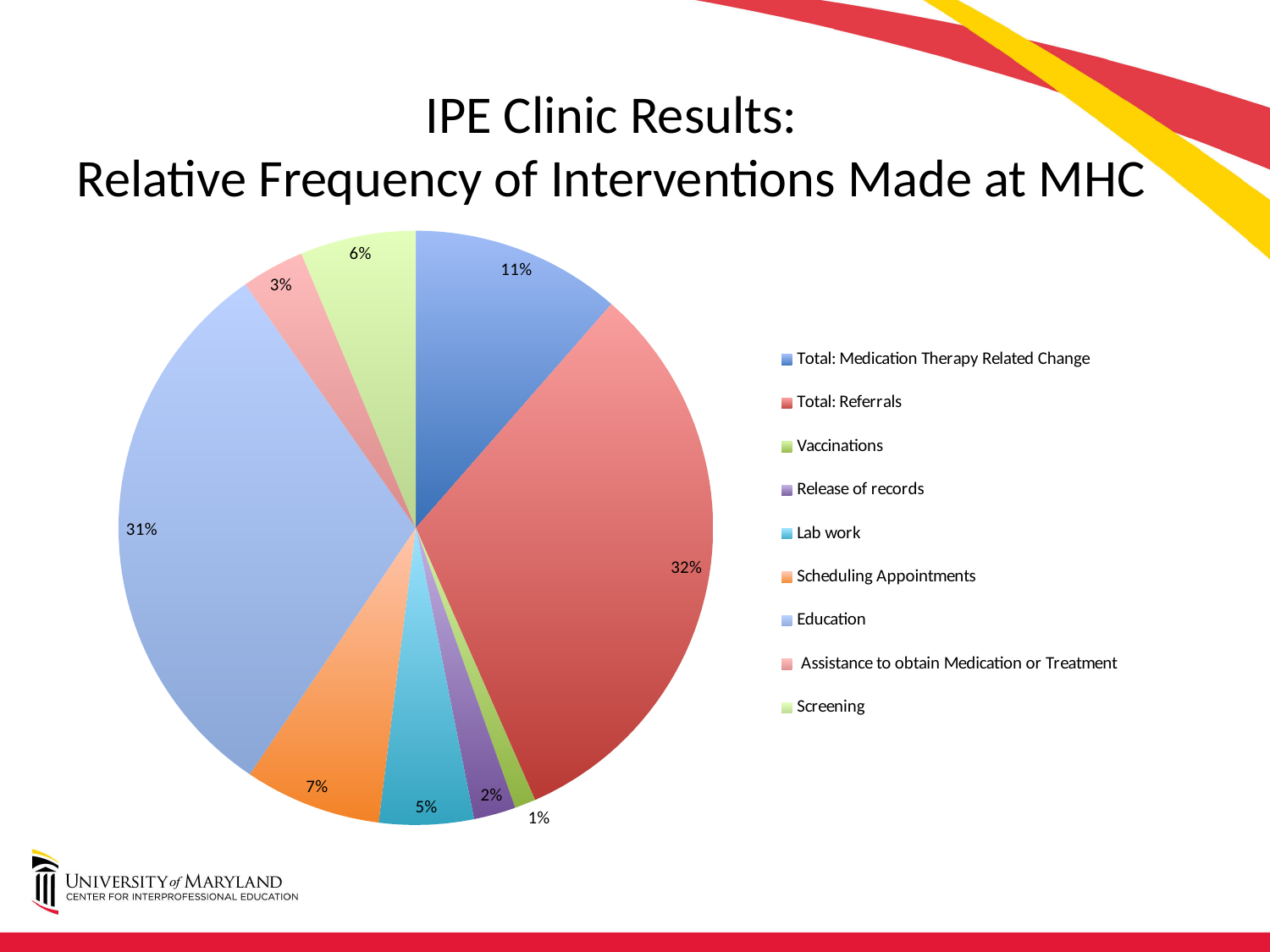
How many categories does the legend list? 9 Which intervention category has the largest share of the pie? Total: Referrals What percentage of interventions were Lab work? 5% Which has a larger share, Scheduling Appointments or Lab work? Scheduling Appointments What percentage of interventions were Scheduling Appointments? 7% What percentage of interventions were Total: Medication Therapy Related Change? 11% What percentage of interventions were Screening? 6% What is the difference in percentage points between Total: Referrals and Education? 1 What kind of chart is shown on the slide? pie chart What percentage of interventions were Total: Referrals? 32% What percentage of interventions were Education? 31% Which intervention category has the smallest share of the pie? Vaccinations